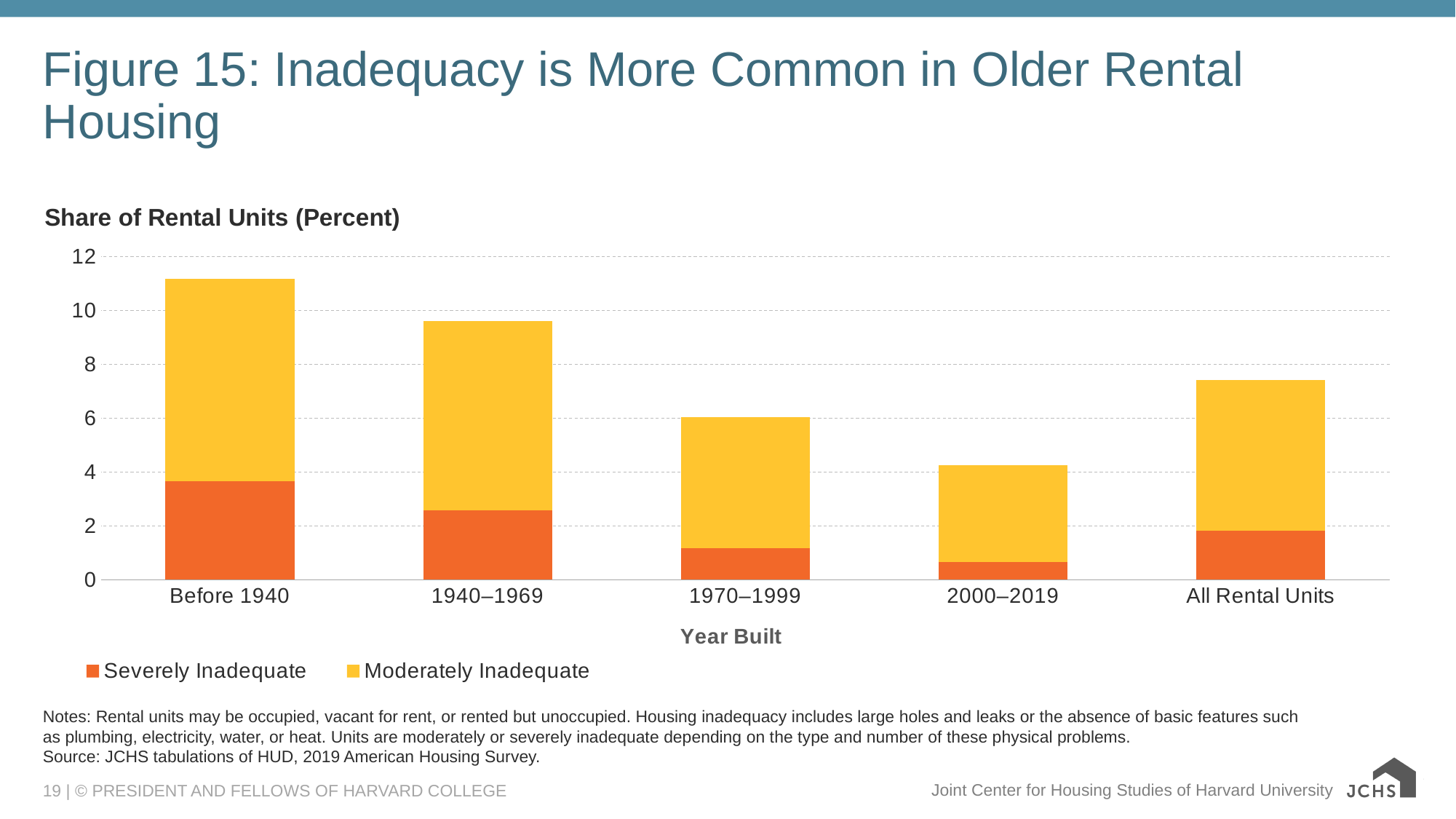
Is the total stacked value for 1940–1969 greater or less than 8? greater Is the total stacked value for Before 1940 greater or less than 10? greater Which category has the tallest stacked bar? Before 1940 How many series does the legend list? 2 Which has a larger Severely Inadequate share, Before 1940 or 1940–1969? Before 1940 What kind of chart is shown on the slide? Stacked bar chart Which category has the shortest stacked bar? 2000–2019 Is the total stacked value for 2000–2019 greater or less than 6? less Moving from Before 1940 to 2000–2019 along the x axis, do the total stacked values rise or fall? Fall How many categories are shown on the x axis? 5 Which series is shown in orange? Severely Inadequate